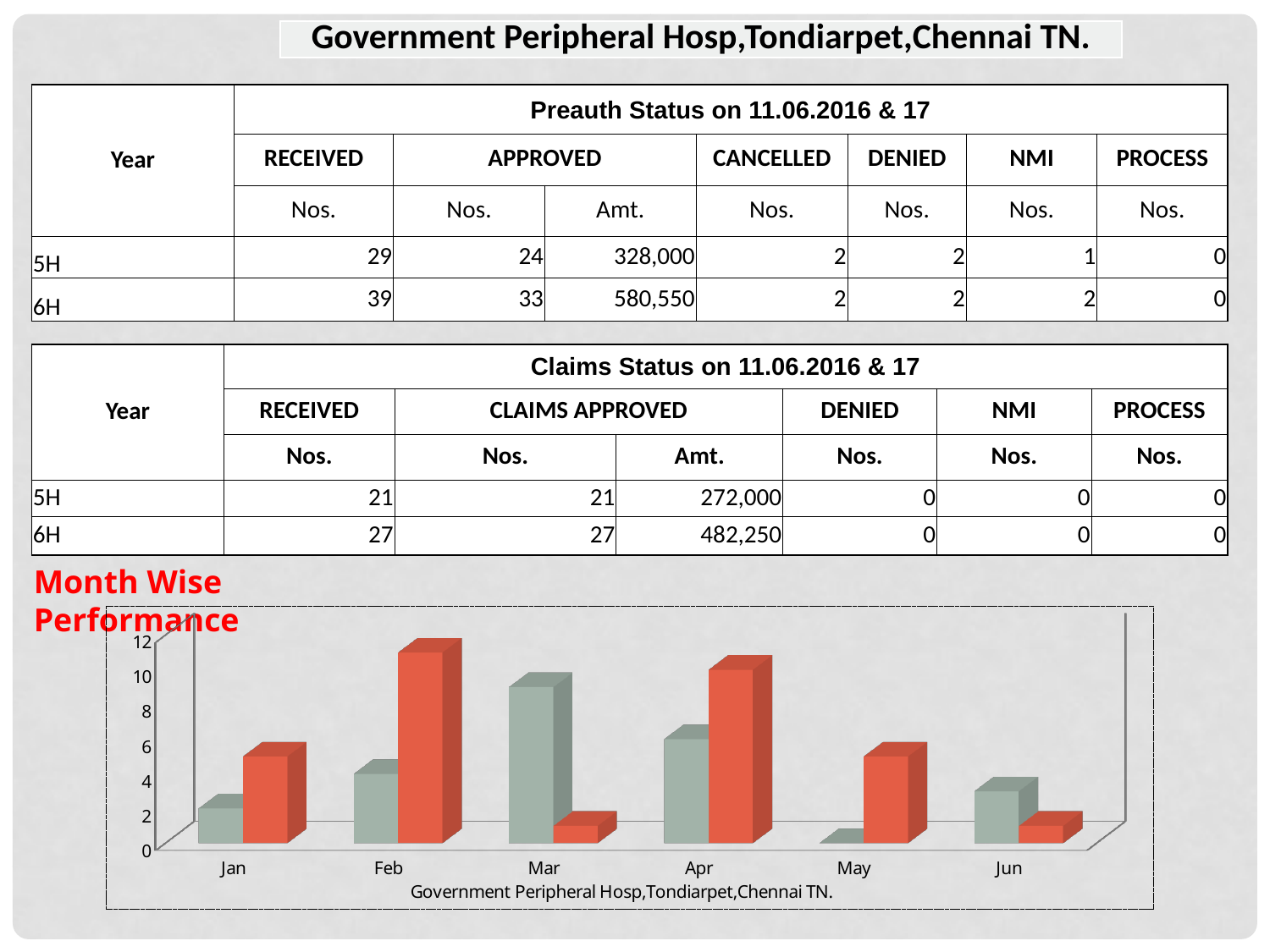
In the Month Wise Performance chart, which is taller for Apr, the grey bar or the red bar? the red bar What kind of chart is shown under the heading 'Month Wise Performance'? bar chart In the Month Wise Performance chart, which month has the tallest grey bar? Mar How many months are shown on the x axis of the Month Wise Performance chart? 6 In the Month Wise Performance chart, which month has the shortest grey bar? May What is the highest value shown on the y axis of the Month Wise Performance chart? 12 In the Month Wise Performance chart, is the grey bar for Jan greater or less than 4? less In the Month Wise Performance chart, is the grey bar for Mar greater or less than 8? greater In the Month Wise Performance chart, is the red bar for Feb greater or less than 10? greater In the Month Wise Performance chart, which is taller for Mar, the grey bar or the red bar? the grey bar In the Month Wise Performance chart, which month has the tallest red bar? Feb